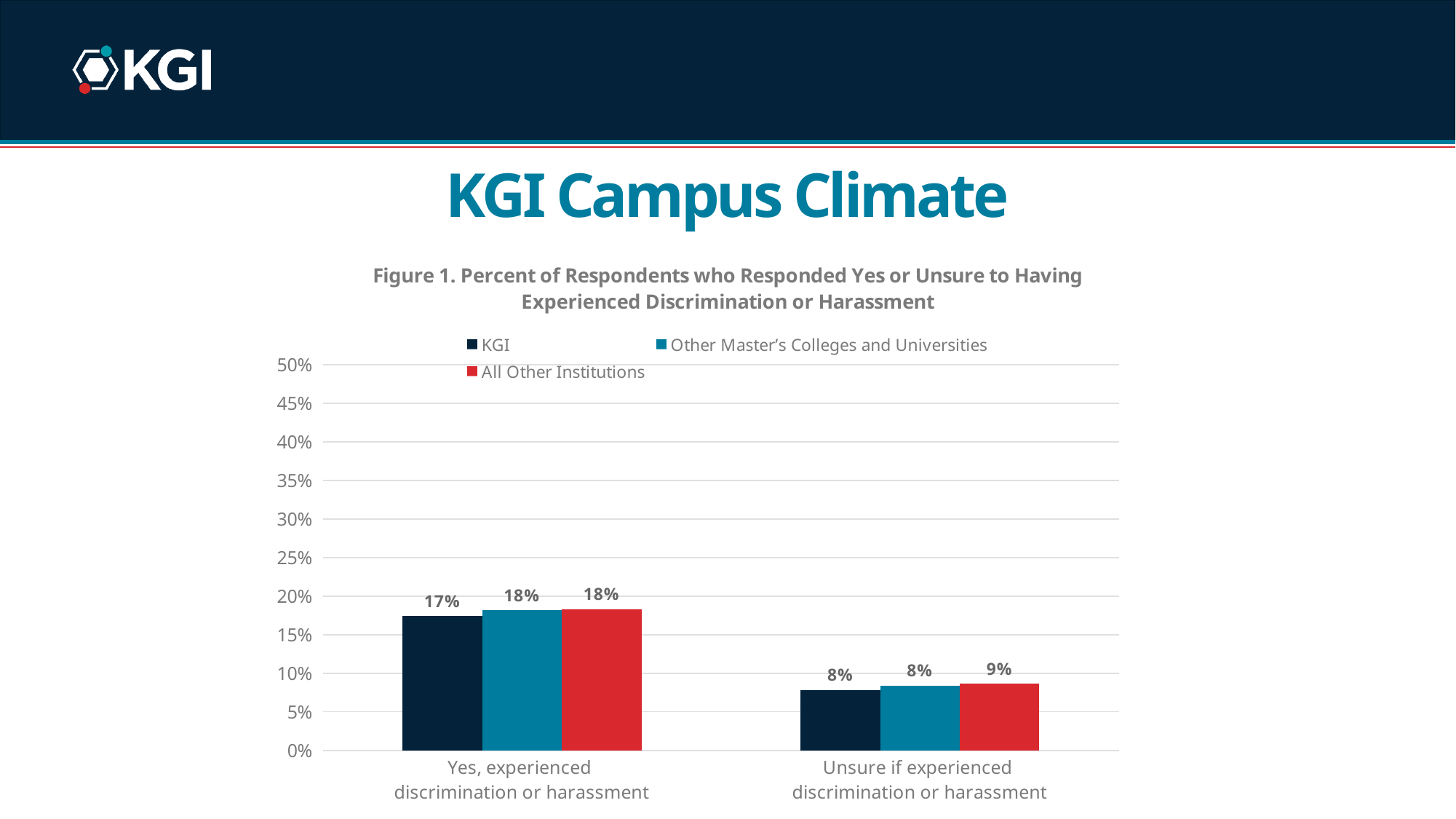
What percentage of KGI respondents said yes, they experienced discrimination or harassment? 17% How many categories are shown on the x axis? 2 Which series is shown in red in the legend? All Other Institutions What is the value for Other Master's Colleges and Universities in the 'Yes, experienced discrimination or harassment' category? 18% What is the difference between the All Other Institutions value and the KGI value in the 'Yes, experienced discrimination or harassment' category? 1% What is the value for KGI in the 'Unsure if experienced discrimination or harassment' category? 8% How many series does the legend list? 3 What is the figure title of the chart? Figure 1. Percent of Respondents who Responded Yes or Unsure to Having Experienced Discrimination or Harassment What is the value for All Other Institutions in the 'Unsure if experienced discrimination or harassment' category? 9% Is the value for Other Master's Colleges and Universities in the 'Yes, experienced discrimination or harassment' category greater or less than 15%? greater What kind of chart is shown on the slide? Bar chart Which category has the higher value for KGI: 'Yes, experienced discrimination or harassment' or 'Unsure if experienced discrimination or harassment'? Yes, experienced discrimination or harassment